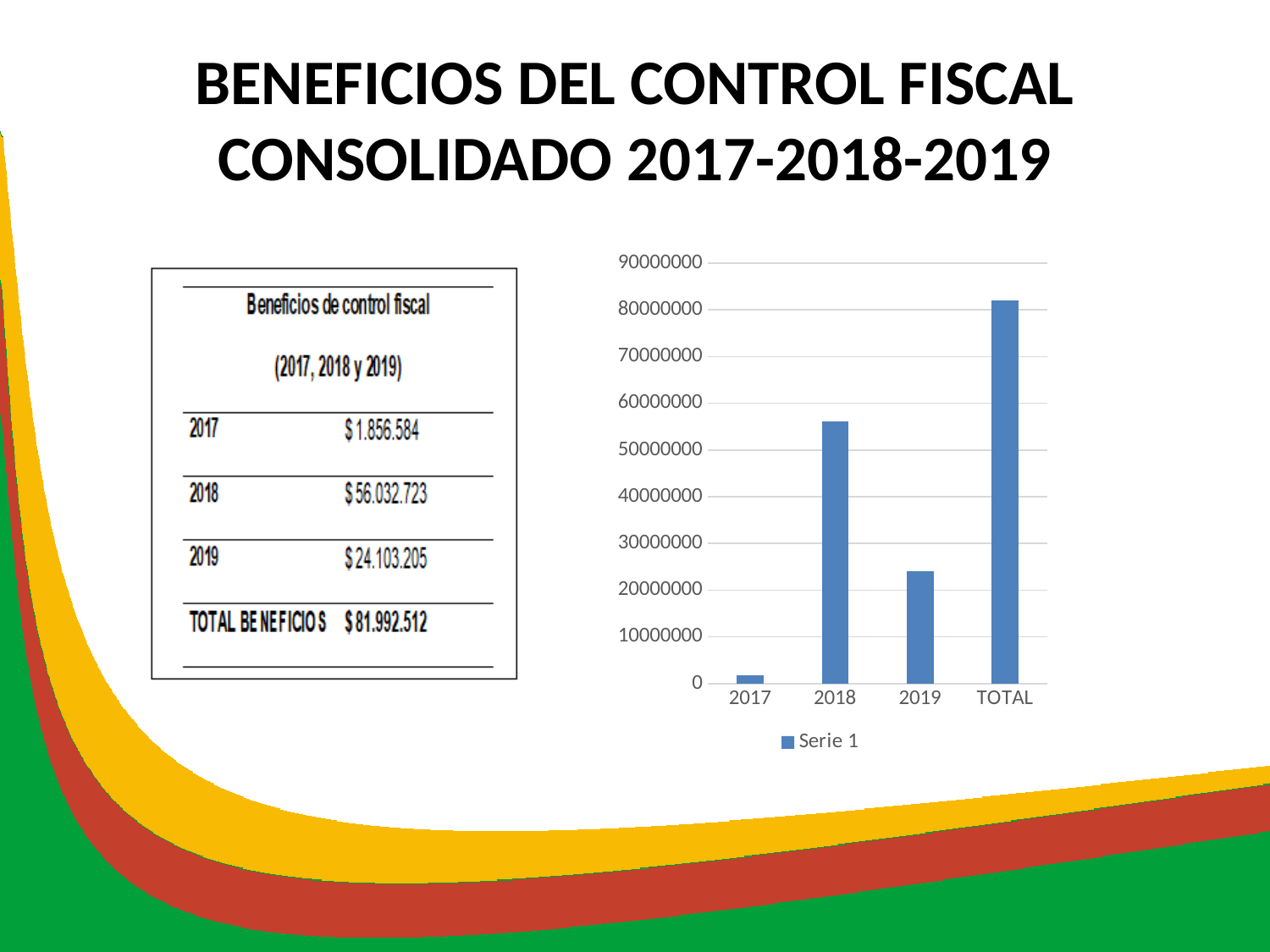
What is the name of the series in the chart legend? Serie 1 Which category has the shortest bar in the chart? 2017 Which category has the tallest bar in the chart? TOTAL Is the value for 2019 greater or less than 30000000? less How many categories are shown on the x axis of the bar chart? 4 Is the value for 2017 greater or less than 10000000? less Is the bar for 2018 taller or shorter than the bar for 2019? taller Among the years 2017, 2018 and 2019, which has the highest bar? 2018 Is the value for 2018 greater or less than 50000000? greater What kind of chart is shown on the slide? bar chart How many series does the chart legend list? 1